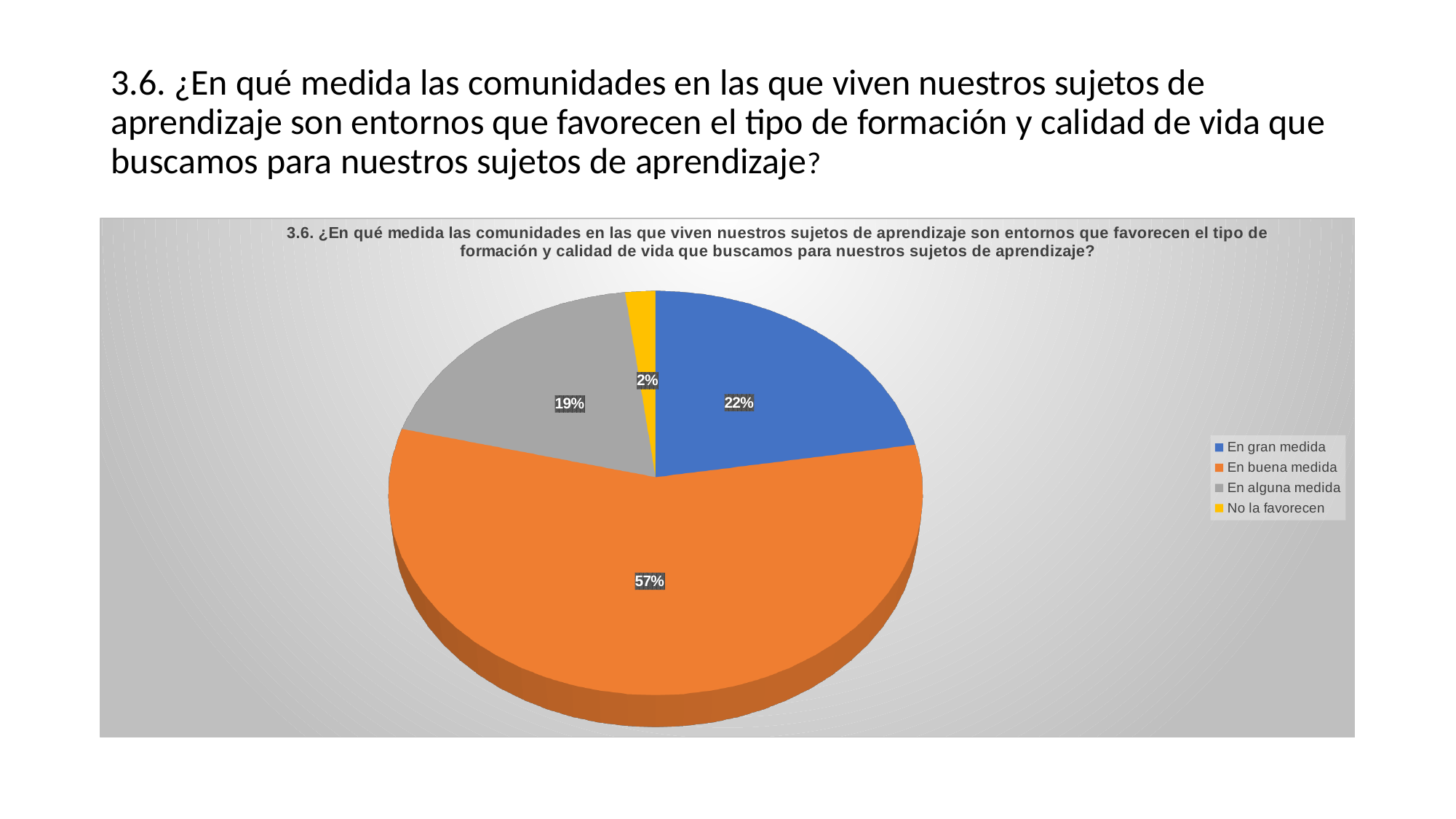
What kind of chart is shown on the slide? Pie chart How many categories does the pie chart have? 4 Which legend entry is shown in yellow? No la favorecen Which category has the smallest share of the pie? No la favorecen What percentage is shown for "En gran medida"? 22% What percentage is shown for "En alguna medida"? 19% Which category has the largest share of the pie? En buena medida What is the difference in percentage points between "En buena medida" and "En gran medida"? 35 What colour is the slice for "En alguna medida"? Grey Which is larger, the share for "En gran medida" or the share for "En alguna medida"? En gran medida What percentage is shown for "No la favorecen"? 2% What percentage is shown for "En buena medida"? 57%